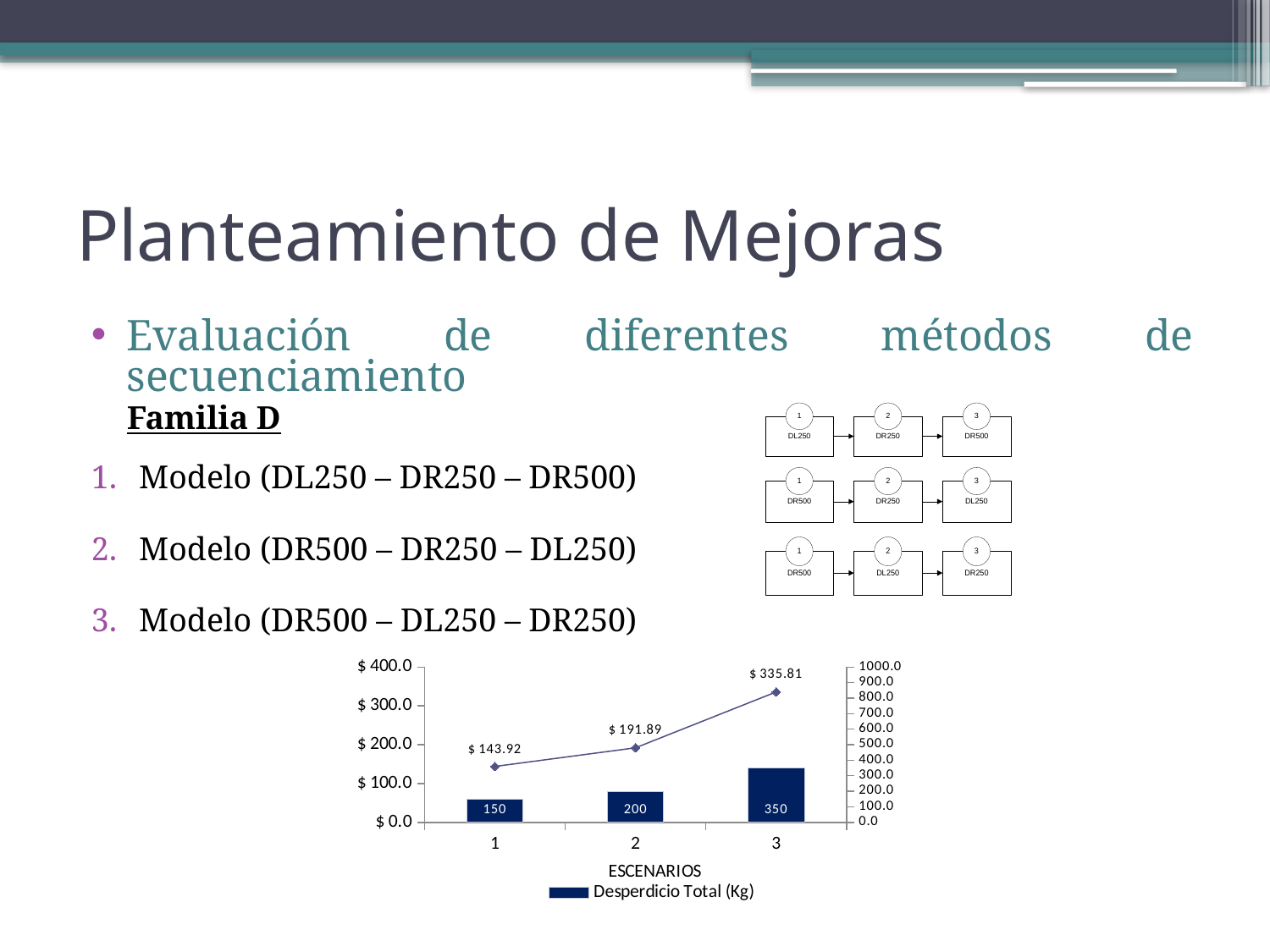
How many escenarios are shown on the x axis of the chart? 3 What is the difference in Desperdicio Total (Kg) between escenario 3 and escenario 2? 150 Which is larger, the Desperdicio Total (Kg) for escenario 1 or for escenario 2? escenario 2 Which escenario has the lowest dollar value on the line? 1 What is the dollar value shown on the line for escenario 2? $ 191.89 What is the Desperdicio Total (Kg) value for escenario 1? 150 What is the dollar value shown on the line for escenario 3? $ 335.81 What is the Desperdicio Total (Kg) value for escenario 3? 350 What is the x-axis title of the chart? ESCENARIOS What series name is shown in the chart legend? Desperdicio Total (Kg) Do the dollar values on the line rise or fall from escenario 1 to escenario 3? rise Which escenario has the highest Desperdicio Total (Kg)? 3